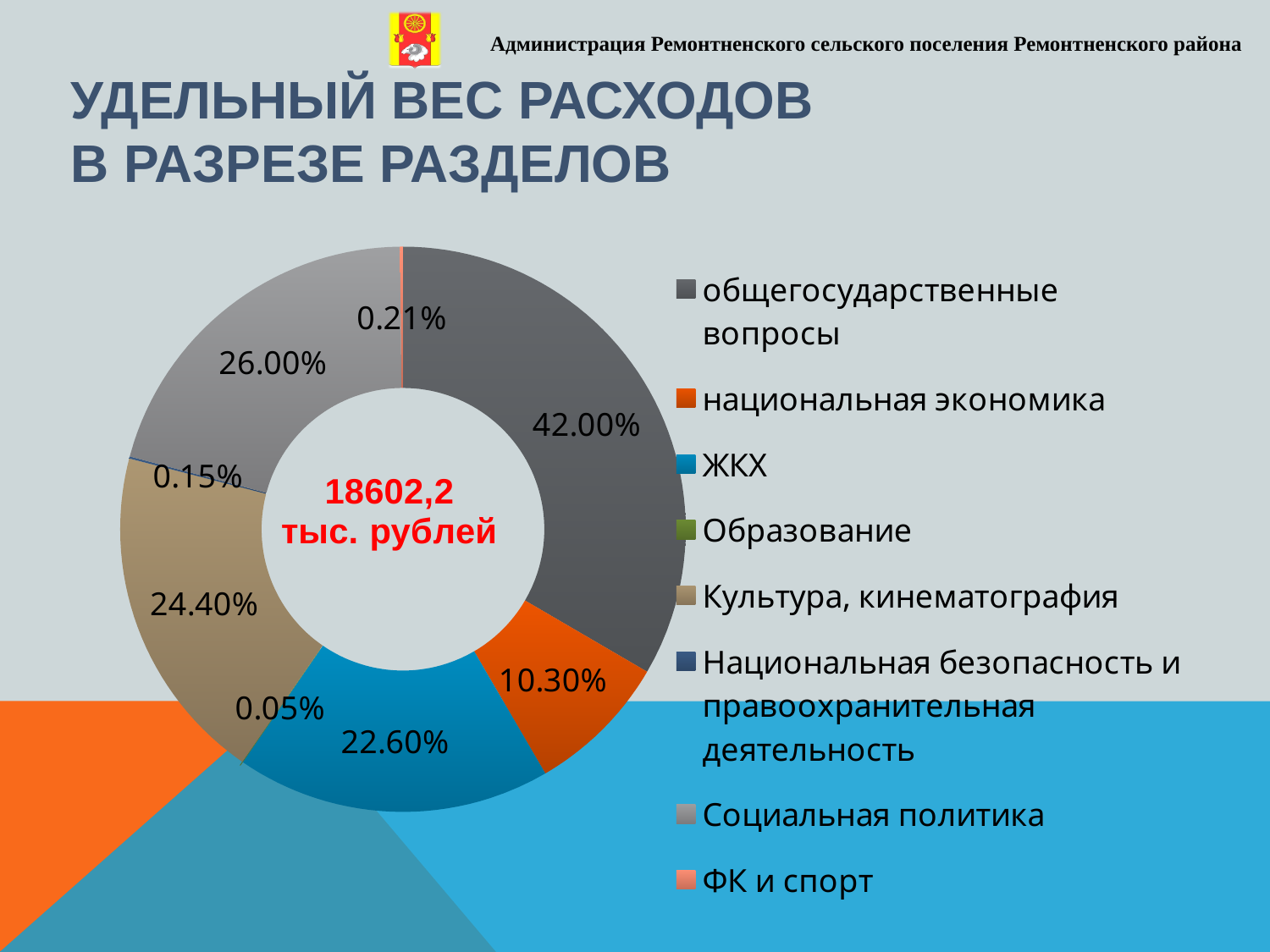
What share of expenditures goes to национальная экономика? 10.30% What total amount of expenditures is shown in the centre of the chart? 18602,2 тыс. рублей What share of expenditures goes to Образование? 0.05% What share of expenditures goes to ЖКХ? 22.60% Which is larger: the share for ЖКХ or the share for национальная экономика? ЖКХ Which section has the smallest share of expenditures? Образование Which section has the largest share of expenditures? общегосударственные вопросы What share of expenditures goes to Социальная политика? 26.00% What share of expenditures goes to Культура, кинематография? 24.40% What is the difference between the shares for Социальная политика and Культура, кинематография? 1.60% How many sections does the legend list? 8 What share of expenditures goes to общегосударственные вопросы? 42.00%